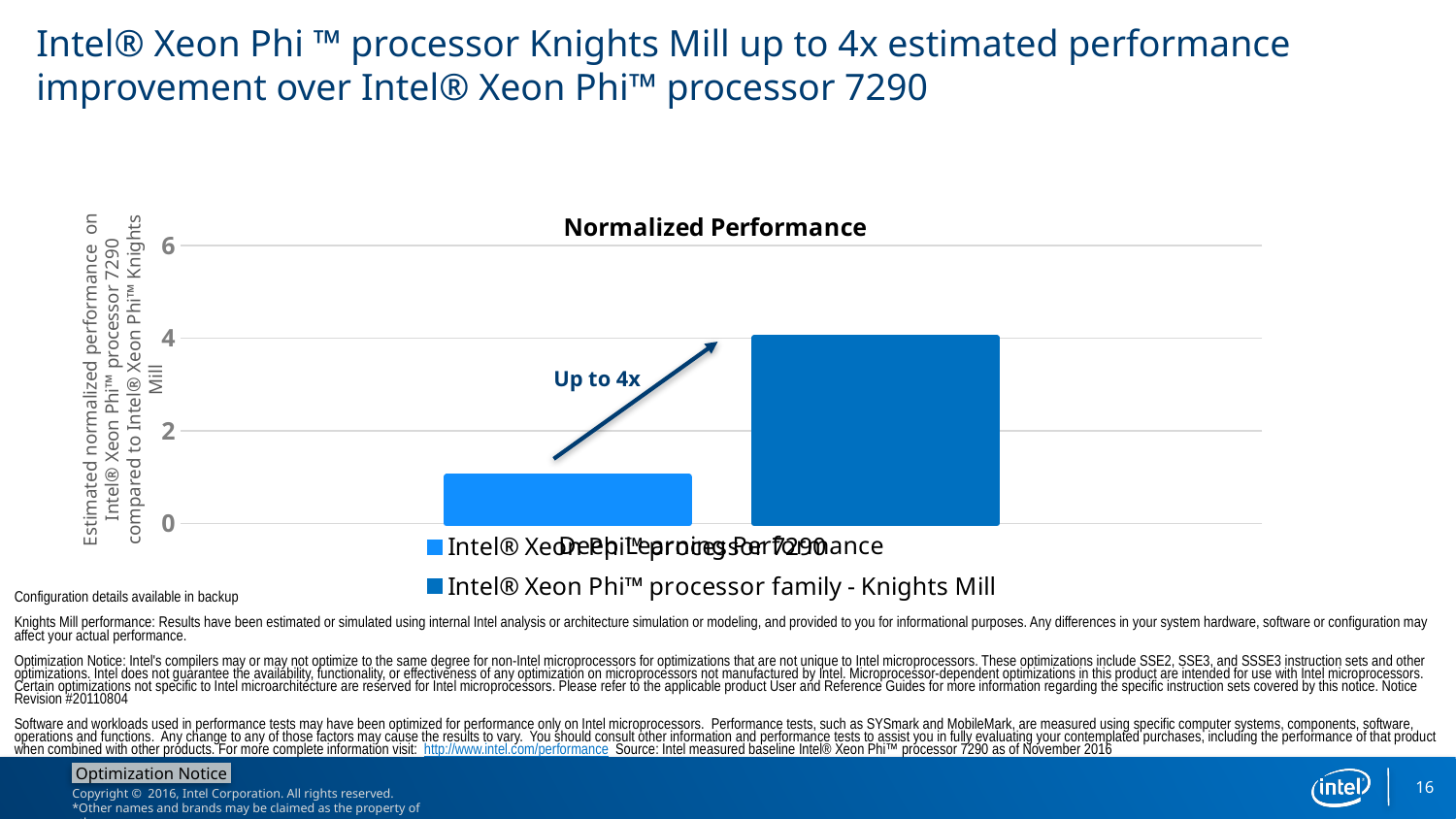
Is the value for Intel® Xeon Phi™ processor 7290 greater or less than 2? less Is the value for Intel® Xeon Phi™ processor family - Knights Mill greater or less than 2? greater What is the title of the chart? Normalized Performance How many bars are plotted in the chart? 2 How many series does the chart legend list? 2 What is the highest tick value shown on the chart's vertical axis? 6 Which series has the highest bar in the chart? Intel® Xeon Phi™ processor family - Knights Mill What kind of chart is shown on the slide? bar chart What normalized performance value does the Intel® Xeon Phi™ processor family - Knights Mill bar reach? 4 Which series has the lowest bar in the chart? Intel® Xeon Phi™ processor 7290 Which bar is taller: Intel® Xeon Phi™ processor 7290 or Intel® Xeon Phi™ processor family - Knights Mill? Intel® Xeon Phi™ processor family - Knights Mill What text is written next to the arrow between the two bars? Up to 4x